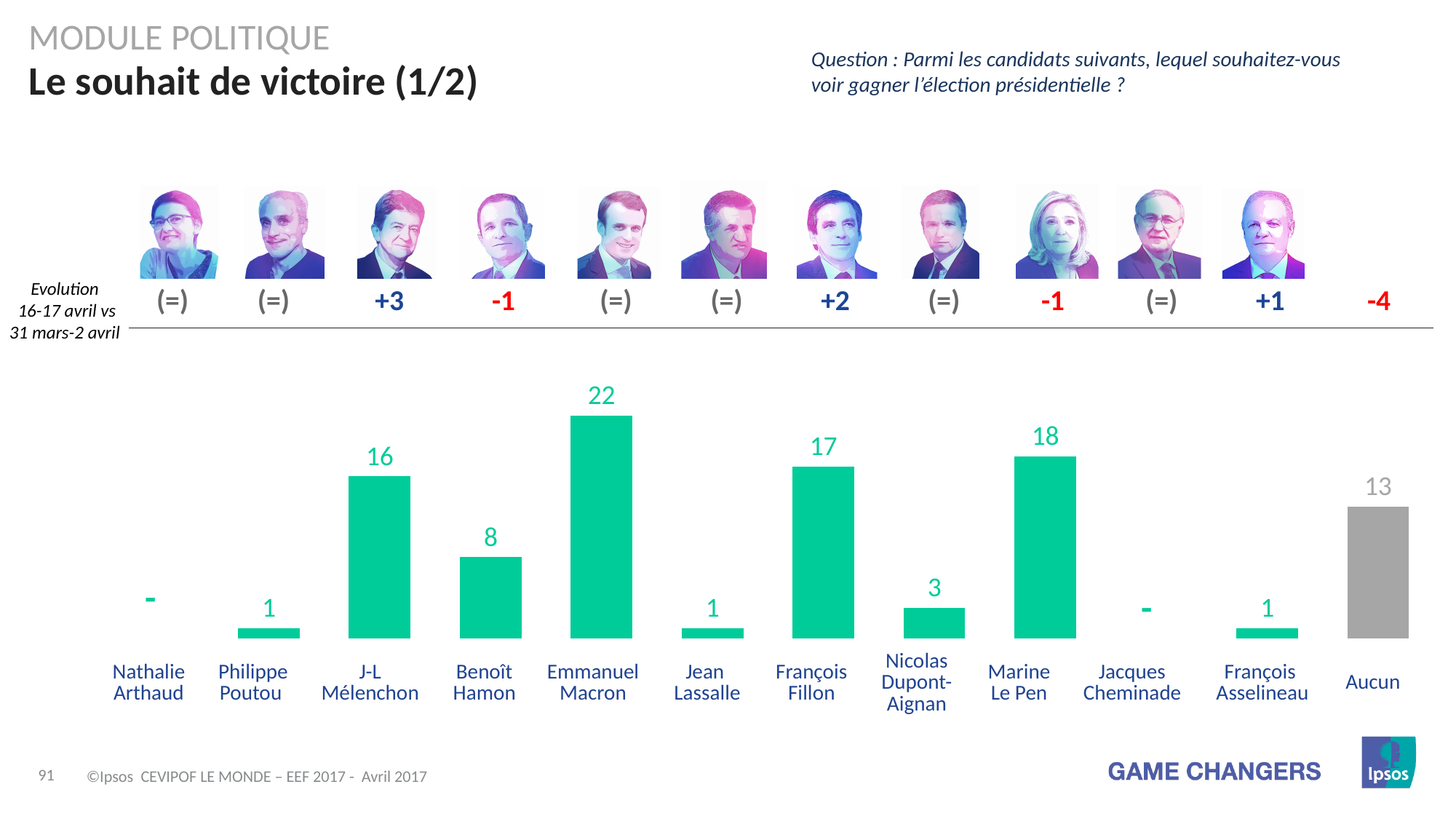
What evolution is shown above J-L Mélenchon's bar (16-17 avril vs 31 mars-2 avril)? +3 Which is larger, the value for Marine Le Pen or the value for François Fillon? Marine Le Pen What evolution is shown above the 'Aucun' bar (16-17 avril vs 31 mars-2 avril)? -4 What value is shown for Emmanuel Macron? 22 Which candidate has the highest value in the chart? Emmanuel Macron What kind of chart is shown on the slide? Bar chart How many categories are shown along the x axis of the chart? 12 What is the difference between the values for J-L Mélenchon and Benoît Hamon? 8 What value is shown for Benoît Hamon? 8 What value is shown for the 'Aucun' bar? 13 What is the difference between the values for Emmanuel Macron and François Fillon? 5 What value is shown for Marine Le Pen? 18